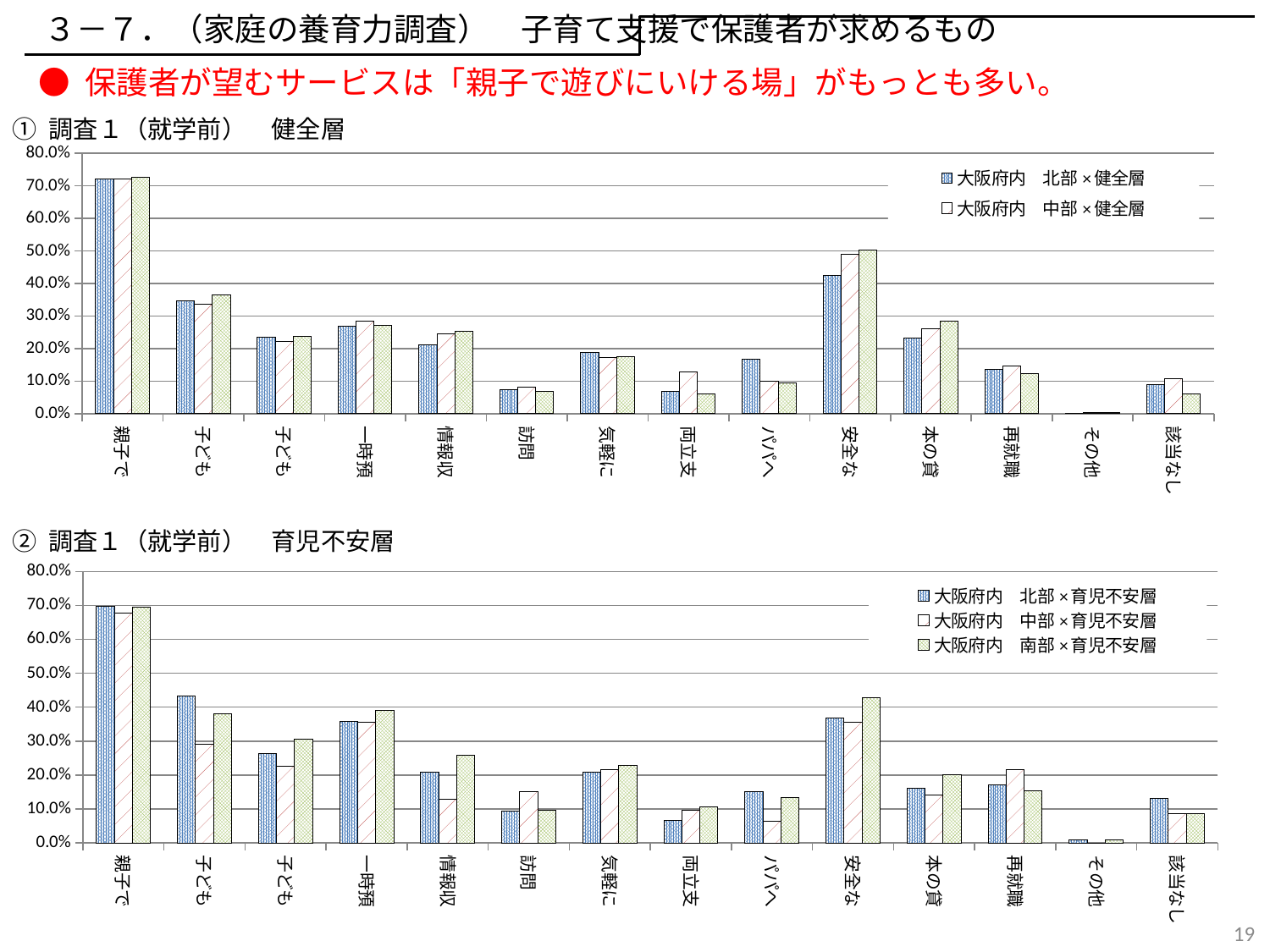
In the bottom chart (② 調査１（就学前） 育児不安層), which is larger for 大阪府内 南部×育児不安層: 一時預 or 訪問? 一時預 In the top chart (① 調査１（就学前） 健全層), is the value for 訪問 (大阪府内 北部×健全層) greater or less than 10.0%? less In the bottom chart (② 調査１（就学前） 育児不安層), is the value for 両立支 (大阪府内 北部×育児不安層) greater or less than 10.0%? less How many categories are shown on the x axis of the bottom chart (② 調査１（就学前） 育児不安層)? 14 In the bottom chart (② 調査１（就学前） 育児不安層), is the value for 一時預 (大阪府内 南部×育児不安層) greater or less than 30.0%? greater In the top chart (① 調査１（就学前） 健全層), which is larger for 大阪府内 北部×健全層: 親子で or 安全な? 親子で How many series does the legend of the bottom chart (② 調査１（就学前） 育児不安層) list? 3 How many series does the legend of the top chart (① 調査１（就学前） 健全層) list? 2 In the top chart (① 調査１（就学前） 健全層), which category has the highest values? 親子で In the bottom chart (② 調査１（就学前） 育児不安層), which category has the lowest values? その他 What kind of chart is the top chart (① 調査１（就学前） 健全層)? bar chart